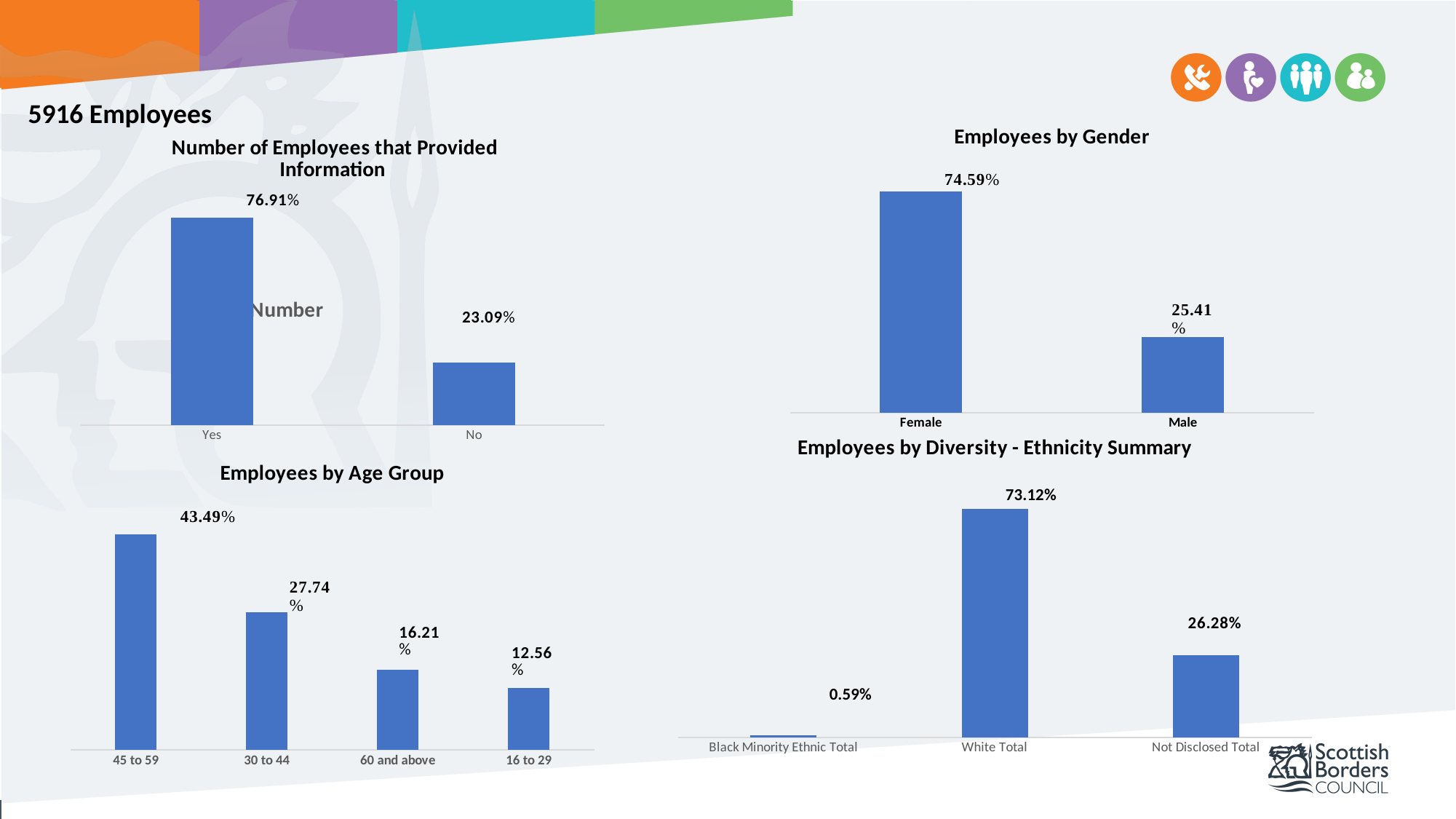
In the 'Employees by Diversity - Ethnicity Summary' chart, what is the value for Black Minority Ethnic Total? 0.59% In the 'Number of Employees that Provided Information' chart, what is the difference between the Yes and No values? 53.82% In the 'Employees by Age Group' chart, how many age groups are shown? 4 In the 'Employees by Age Group' chart, which age group has the lowest value? 16 to 29 In the 'Employees by Diversity - Ethnicity Summary' chart, which category has the highest value? White Total What kind of chart is 'Employees by Gender'? bar chart In the 'Employees by Gender' chart, what is the value for Male? 25.41% In the 'Employees by Age Group' chart, what is the difference between the 45 to 59 and 60 and above values? 27.28% In the 'Number of Employees that Provided Information' chart, what is the value for Yes? 76.91% In the 'Employees by Age Group' chart, what is the value for 30 to 44? 27.74% In the 'Employees by Gender' chart, which category has the higher value? Female In the 'Employees by Diversity - Ethnicity Summary' chart, is the value for Not Disclosed Total larger or smaller than the value for White Total? smaller